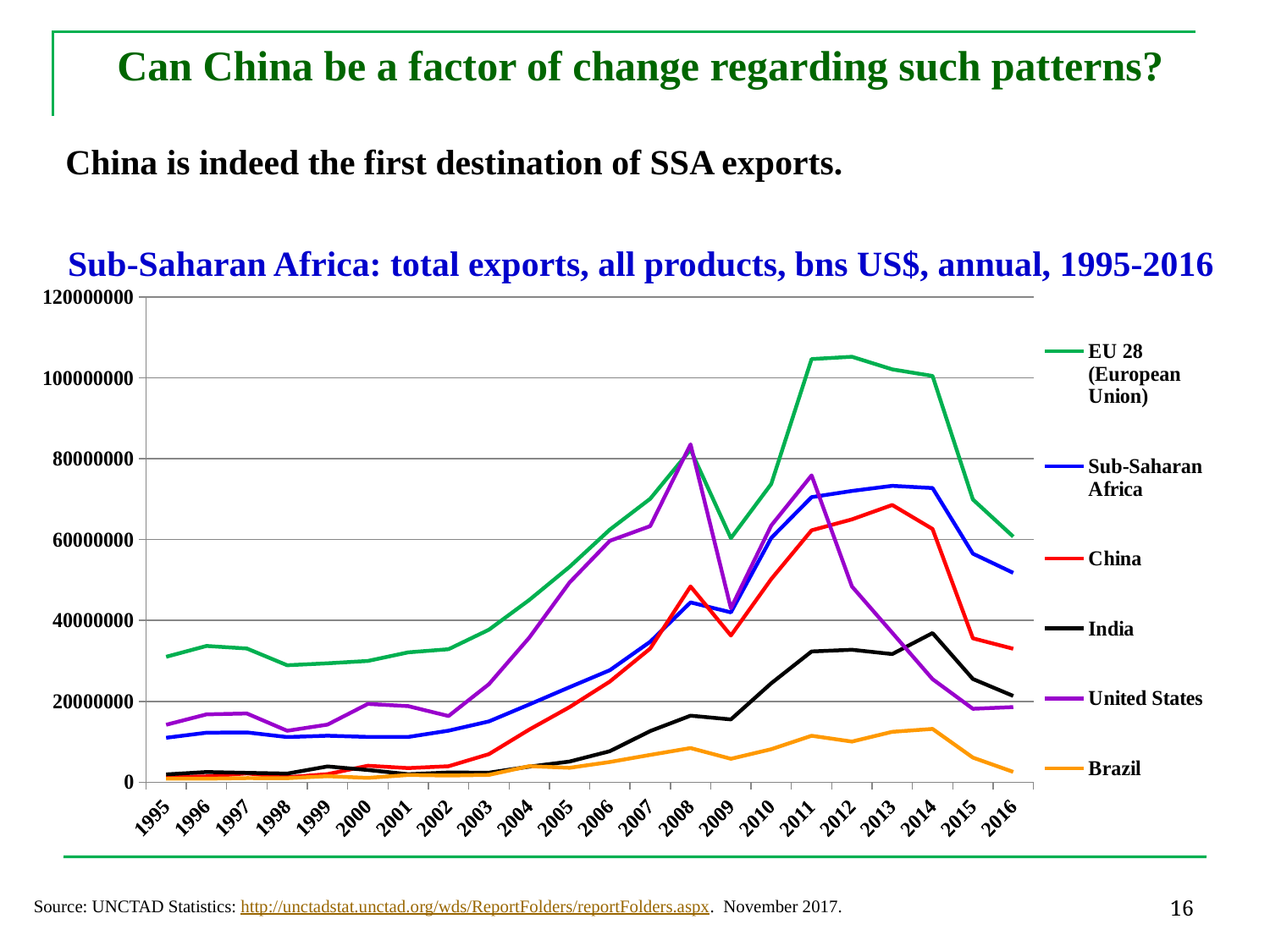
Does the EU 28 (European Union) line rise or fall from 2013 to 2016? fall Which series has the highest value in 2012? EU 28 (European Union) How many series does the legend list? 6 In 2016, which is larger: the value for Sub-Saharan Africa or the value for United States? Sub-Saharan Africa How many years are plotted along the x axis? 22 What kind of chart is shown on the slide? line chart In 2013, which is larger: the value for China or the value for India? China Is the value for China in 2016 greater or less than 40000000? less What is the title of the chart? Sub-Saharan Africa: total exports, all products, bns US$, annual, 1995-2016 Which series has the lowest value in 2016? Brazil Is the value for India in 2014 greater or less than 20000000? greater Is the value for EU 28 (European Union) in 2012 greater or less than 100000000? greater